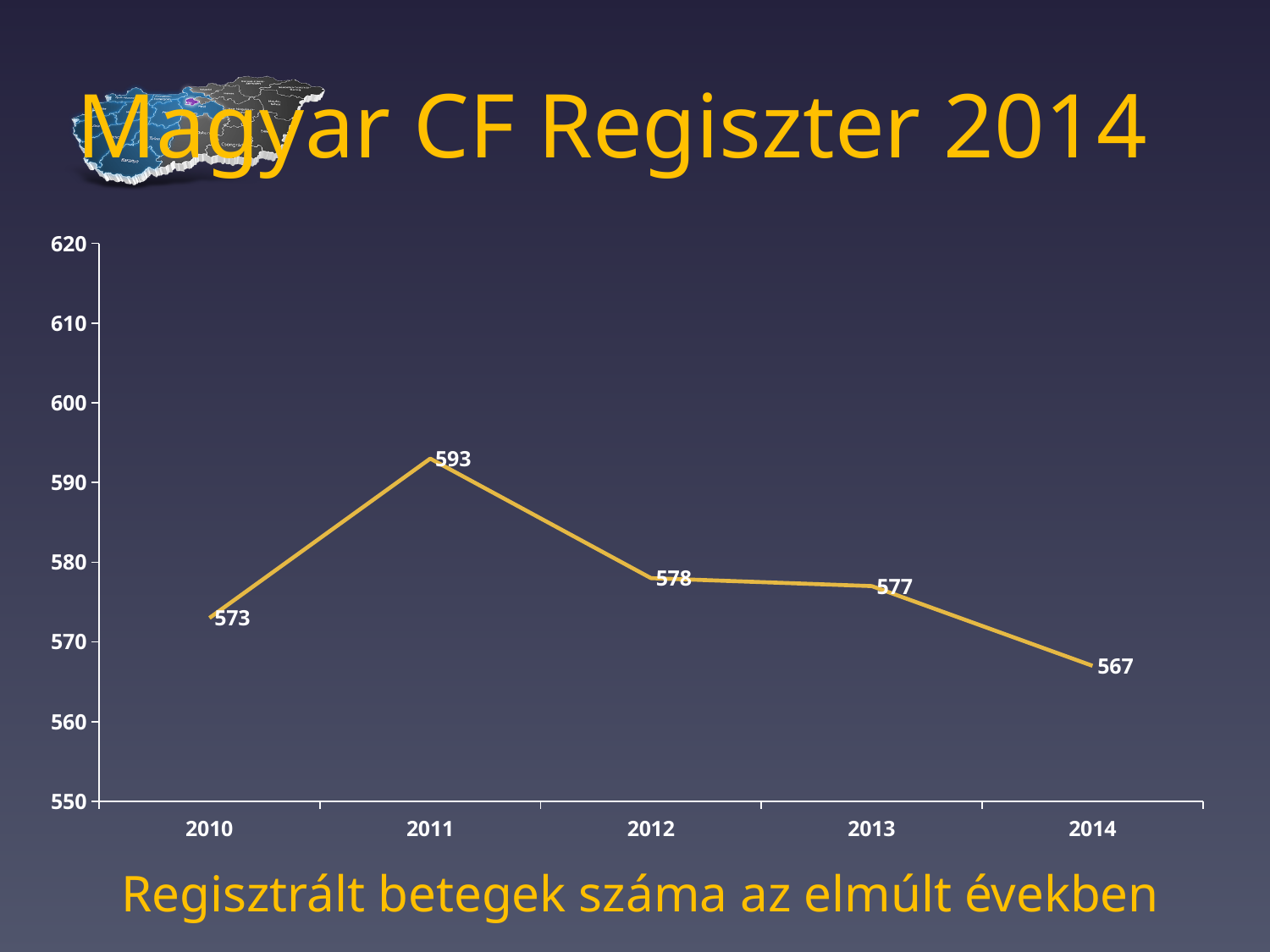
Which year has the highest value? 2011 What is the difference between the values for 2012 and 2013? 1 What is the value for 2011? 593 How many years are plotted on the chart? 5 What is the difference between the values for 2011 and 2014? 26 What kind of chart is shown on the slide? line chart Do the values rise or fall from 2011 to 2014? fall What is the value for 2010? 573 Which year has the lowest value? 2014 Is the value for 2011 greater or less than 590? greater What is the value for 2014? 567 Which is larger, the value for 2010 or the value for 2012? 2012